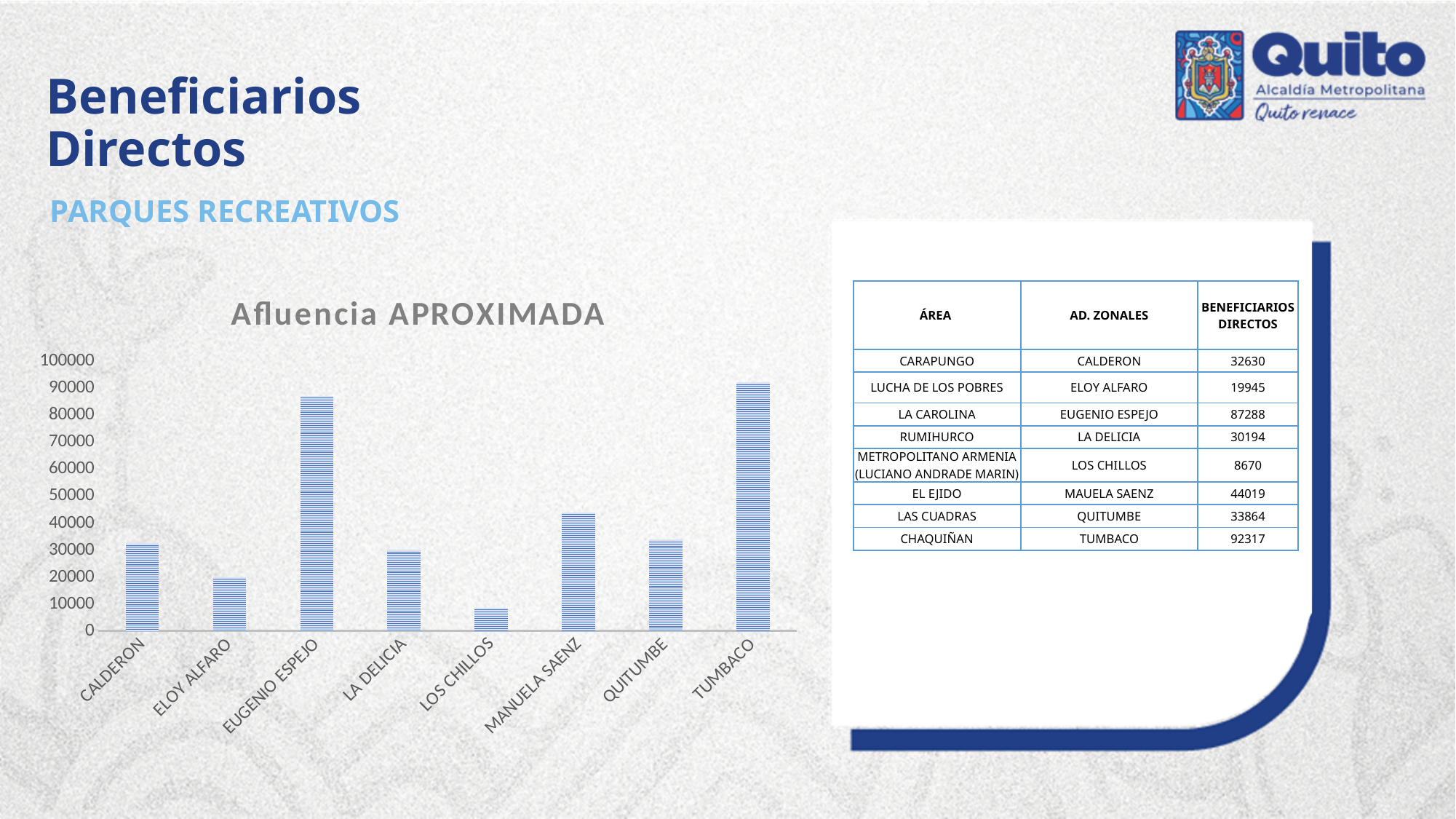
Which zone has the lowest bar in the chart? LOS CHILLOS Which zone has the highest bar in the chart? TUMBACO What is the title of the chart? Afluencia APROXIMADA According to the table on the slide, how many beneficiarios directos does EUGENIO ESPEJO have? 87288 According to the table on the slide, how many beneficiarios directos does TUMBACO have? 92317 Is the value for LOS CHILLOS greater or less than 10000? less Is the value for MANUELA SAENZ greater or less than 40000? greater Is the value for EUGENIO ESPEJO greater or less than 80000? greater Using the values in the table, what is the difference between TUMBACO and EUGENIO ESPEJO? 5029 Which is larger, the bar for MANUELA SAENZ or the bar for LA DELICIA? MANUELA SAENZ How many zones (categories) are plotted in the chart? 8 What kind of chart is shown on the slide? bar chart